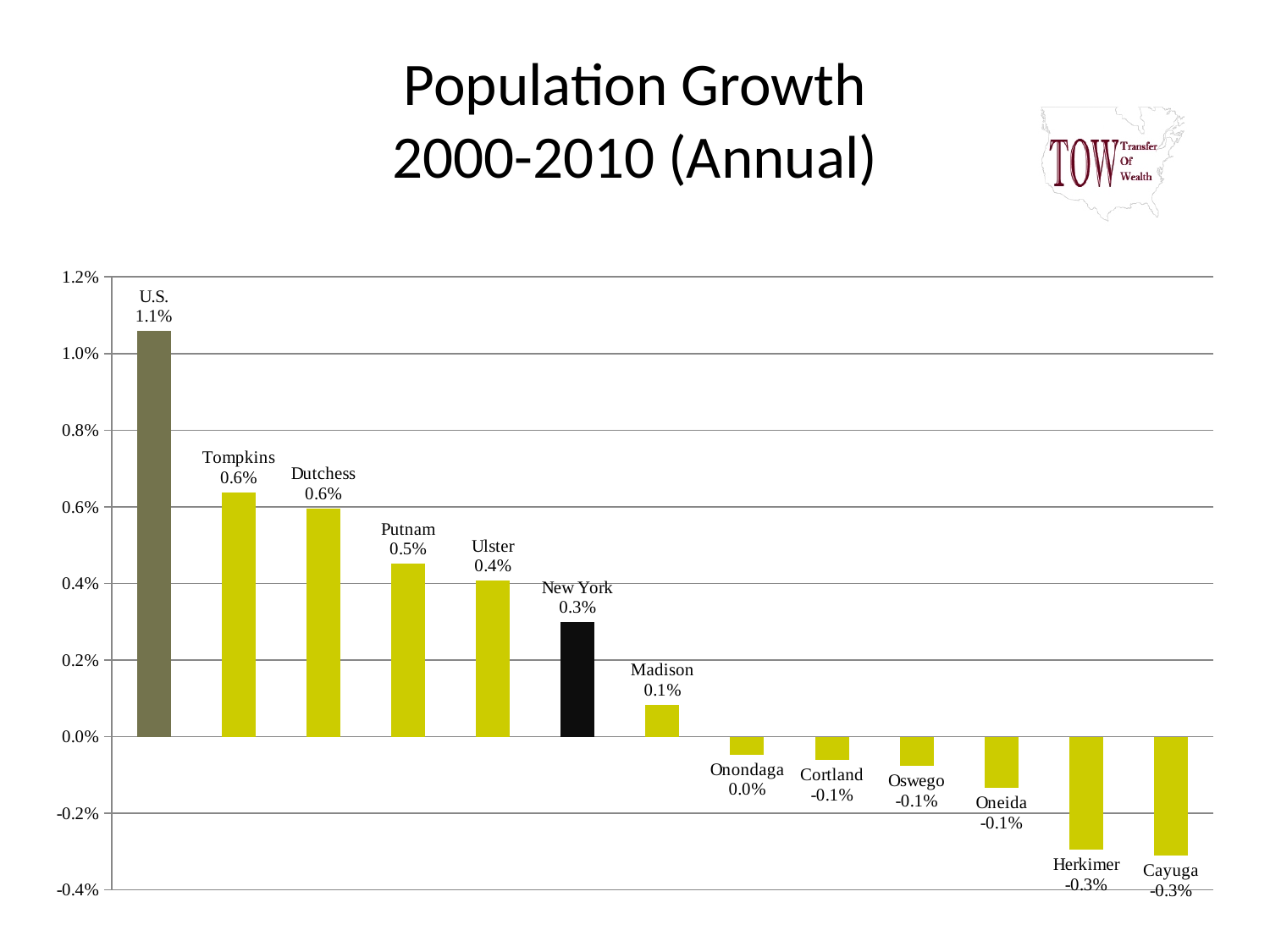
Do the values generally rise or fall moving from left to right along the x axis? Fall What kind of chart is shown on the slide? Bar chart What is the annual population growth value shown for Putnam? 0.5% Which has the larger annual population growth, Putnam or Ulster? Putnam What is the difference between the U.S. value and the New York value? 0.8% Is the value for Tompkins greater or less than 0.4%? greater What is the annual population growth value shown for New York? 0.3% Which category has the highest annual population growth on the chart? U.S. What is the difference between the Putnam value and the Madison value? 0.4% What is the annual population growth value shown for Herkimer? -0.3% What is the annual population growth value shown for the U.S.? 1.1% How many categories (bars) are shown on the chart? 13